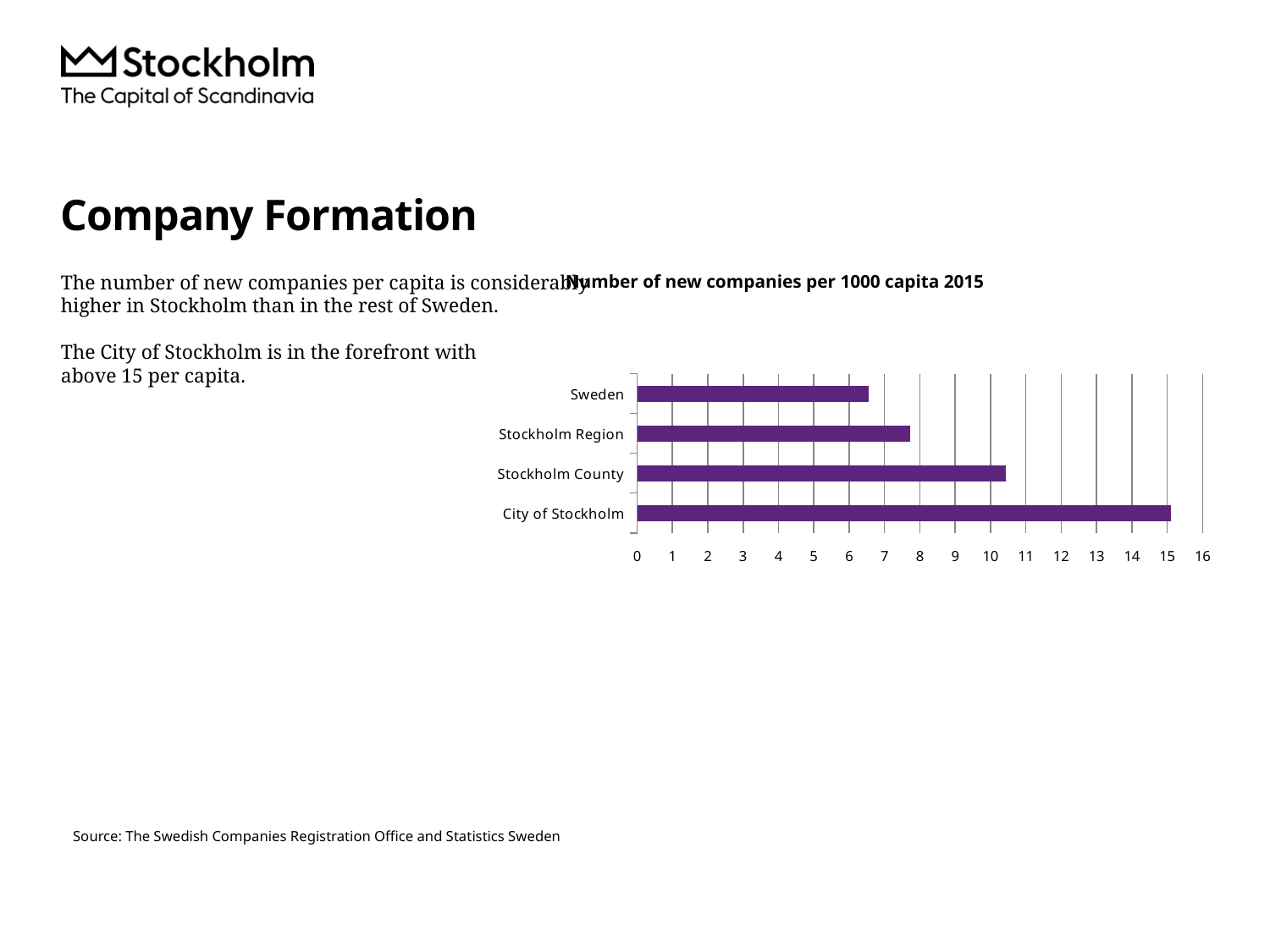
Which category has the lowest number of new companies per 1000 capita? Sweden What kind of chart is shown on the slide? Bar chart How many categories are plotted in the chart? 4 What is the maximum value shown on the horizontal axis of the chart? 16 Is the value for Stockholm Region greater or less than 7? greater Which has a higher value, Stockholm County or Stockholm Region? Stockholm County What is the title of the chart? Number of new companies per 1000 capita 2015 Is the value for Stockholm County greater or less than 9? greater Which has a higher value, Sweden or City of Stockholm? City of Stockholm Which category has the highest number of new companies per 1000 capita? City of Stockholm Is the value for Sweden greater or less than 7? less